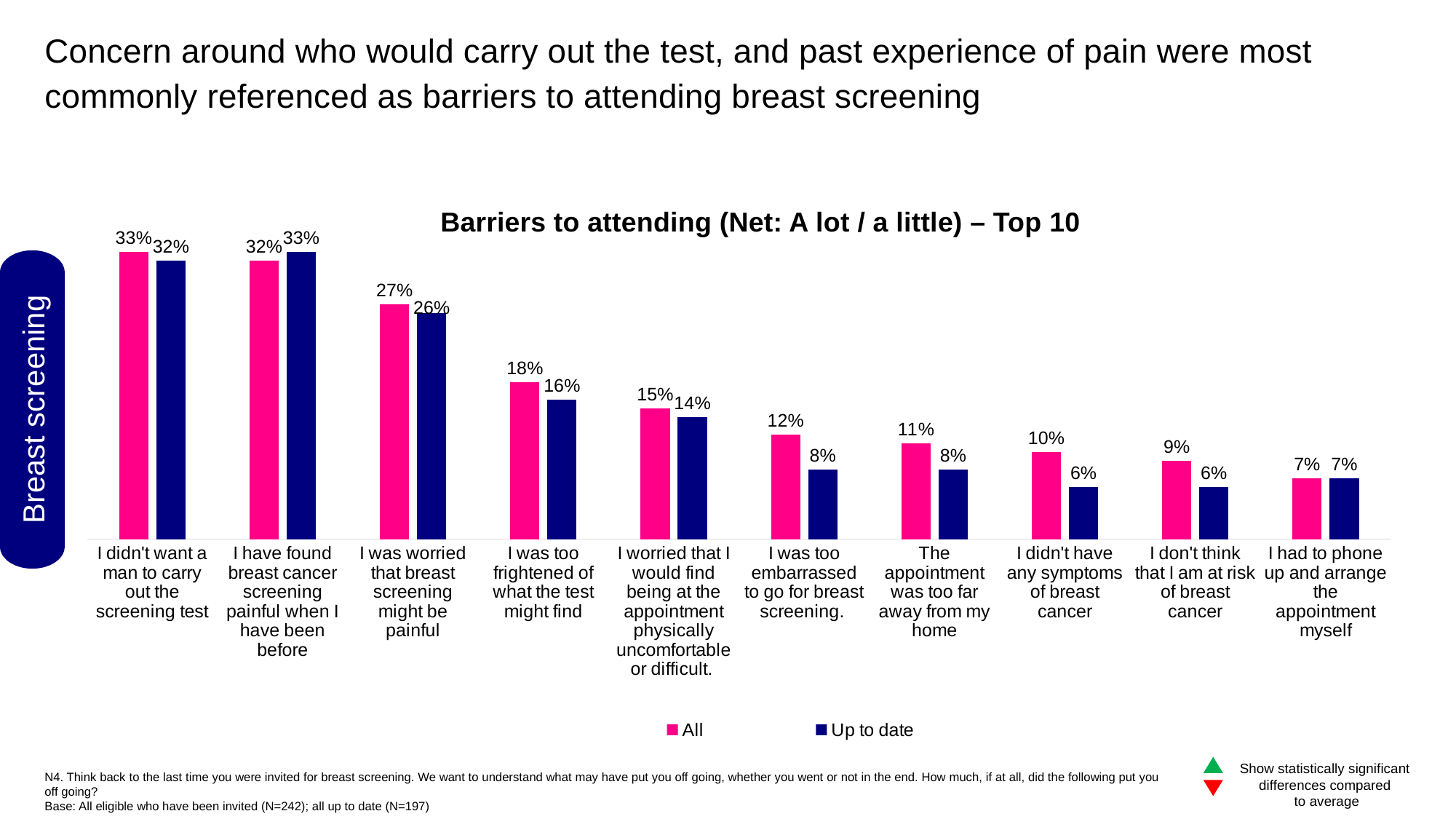
Which barrier has the lowest 'All' value? I had to phone up and arrange the appointment myself What is the title of the chart? Barriers to attending (Net: A lot / a little) – Top 10 What is the 'All' value for 'The appointment was too far away from my home'? 11% What is the 'Up to date' value for 'I was too frightened of what the test might find'? 16% What is the difference between the 'All' and 'Up to date' values for 'I didn't have any symptoms of breast cancer'? 4 percentage points What type of chart is shown? Bar chart How many barriers are shown on the chart? 10 Do the 'All' values rise or fall moving from left to right across the categories? Fall How many series does the legend list? 2 What is the 'All' value for 'I was too embarrassed to go for breast screening.'? 12% For 'I was worried that breast screening might be painful', which is larger: the 'All' value or the 'Up to date' value? All Which barrier has the highest 'Up to date' value? I have found breast cancer screening painful when I have been before